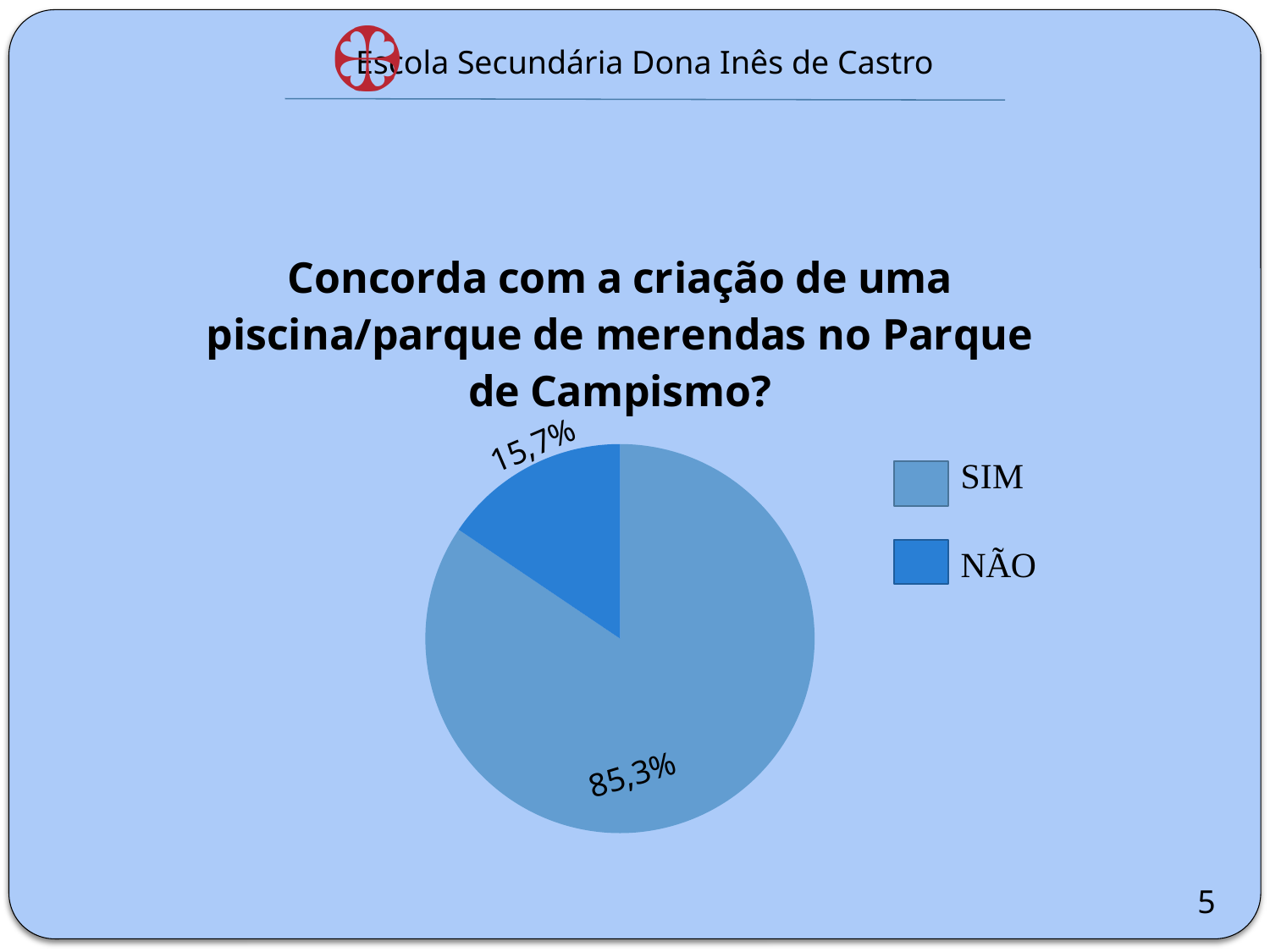
Which is larger, the share for SIM or the share for NÃO? SIM Which legend entry is shown in the darker blue colour? NÃO What is the title of the chart? Concorda com a criação de uma piscina/parque de merendas no Parque de Campismo? What is the difference in percentage points between the SIM and NÃO shares? 69,6 What percentage of respondents answered NÃO? 15,7% How many entries does the legend list? 2 Which response has the largest share of the pie? SIM Which response has the smallest share of the pie? NÃO What kind of chart is shown on the slide? pie chart What percentage of respondents answered SIM? 85,3% How many slices does the pie chart have? 2